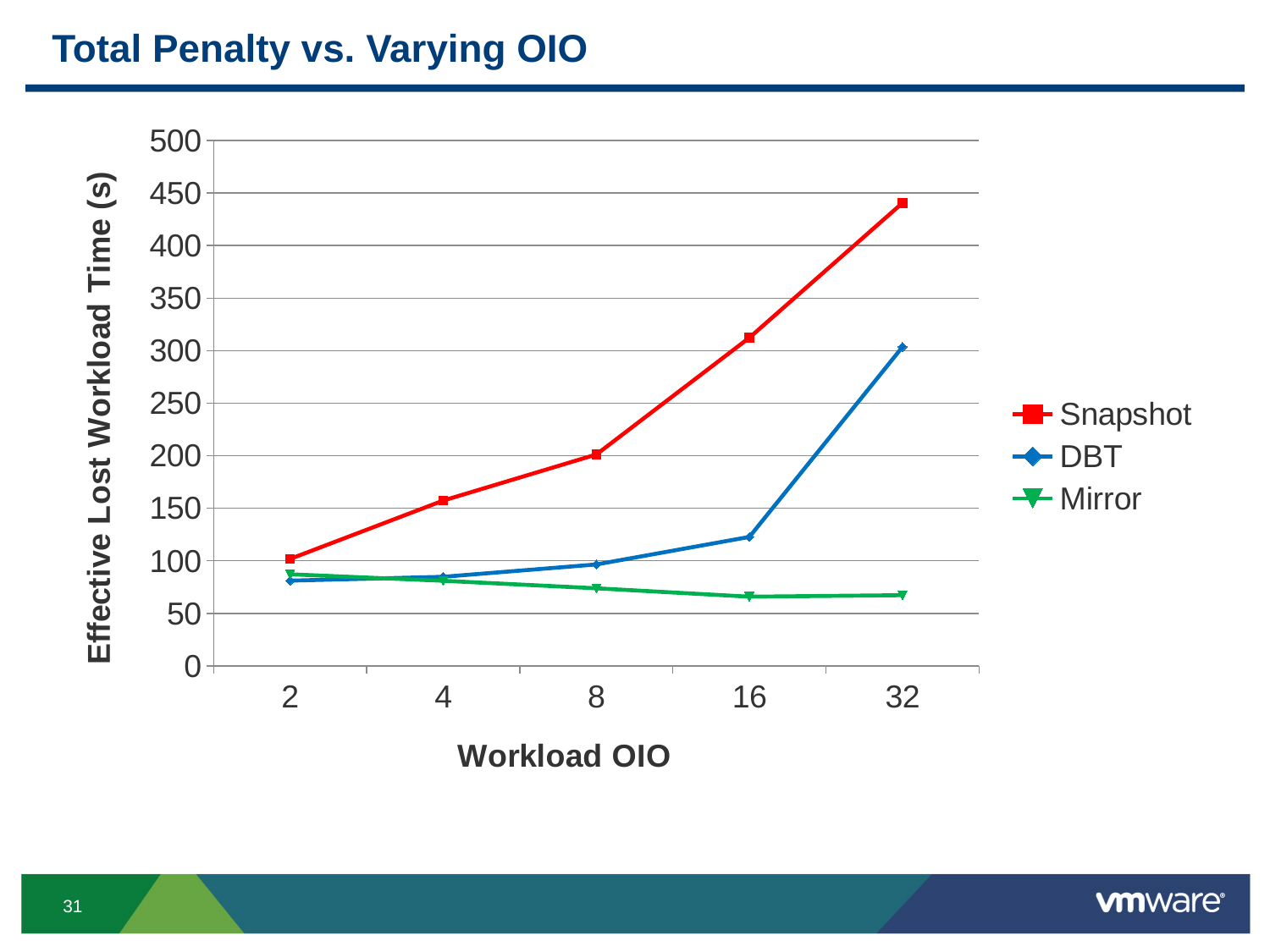
At Workload OIO 32, which series is larger, DBT or Mirror? DBT Which series has the lowest Effective Lost Workload Time at Workload OIO 32? Mirror At Workload OIO 16, which series is larger, Snapshot or DBT? Snapshot Is the Mirror value at Workload OIO 16 greater or less than 100? less Which series has the highest Effective Lost Workload Time at Workload OIO 32? Snapshot What kind of chart is shown on the slide? line chart How many Workload OIO values are plotted along the x axis? 5 What is the title of the y axis? Effective Lost Workload Time (s) Is the Snapshot value at Workload OIO 32 greater or less than 400? greater How many series does the legend list? 3 Does the Snapshot series rise or fall as Workload OIO increases from 2 to 32? rise Is the DBT value at Workload OIO 2 greater or less than 100? less